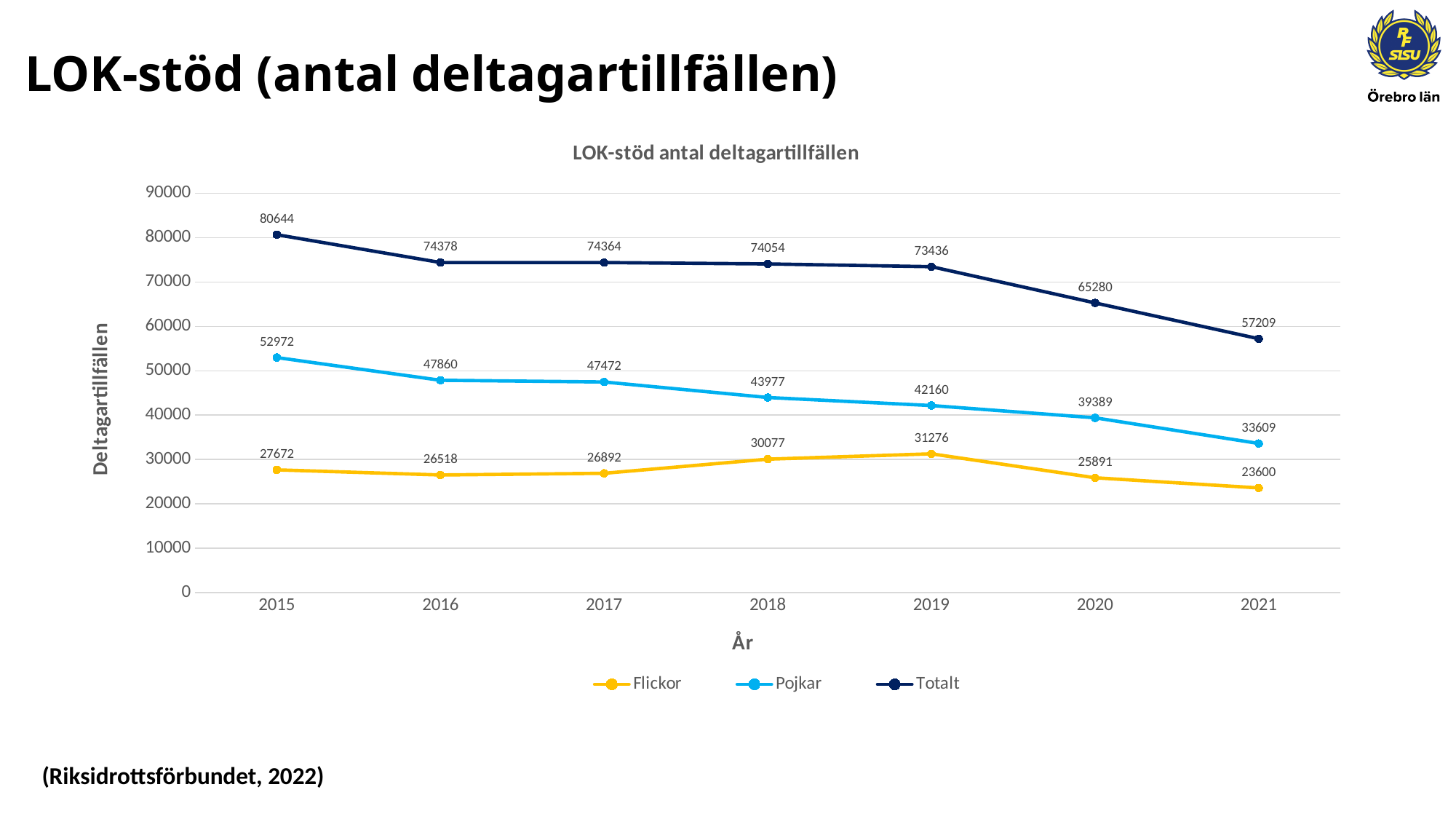
What is the difference between the Totalt value in 2015 and in 2021? 23435 What is the difference between the Pojkar value in 2015 and in 2021? 19363 How many years are shown on the x axis? 7 What is the value for Pojkar in 2018? 43977 Which is larger, the Pojkar value in 2016 or the Pojkar value in 2019? 2016 In which year is the Flickor series highest? 2019 What kind of chart is shown on the slide? line chart What is the value for Totalt in 2015? 80644 In which year is the Totalt series lowest? 2021 How many series does the legend list? 3 What is the value for Flickor in 2021? 23600 Does the Pojkar series rise or fall from 2015 to 2021? fall